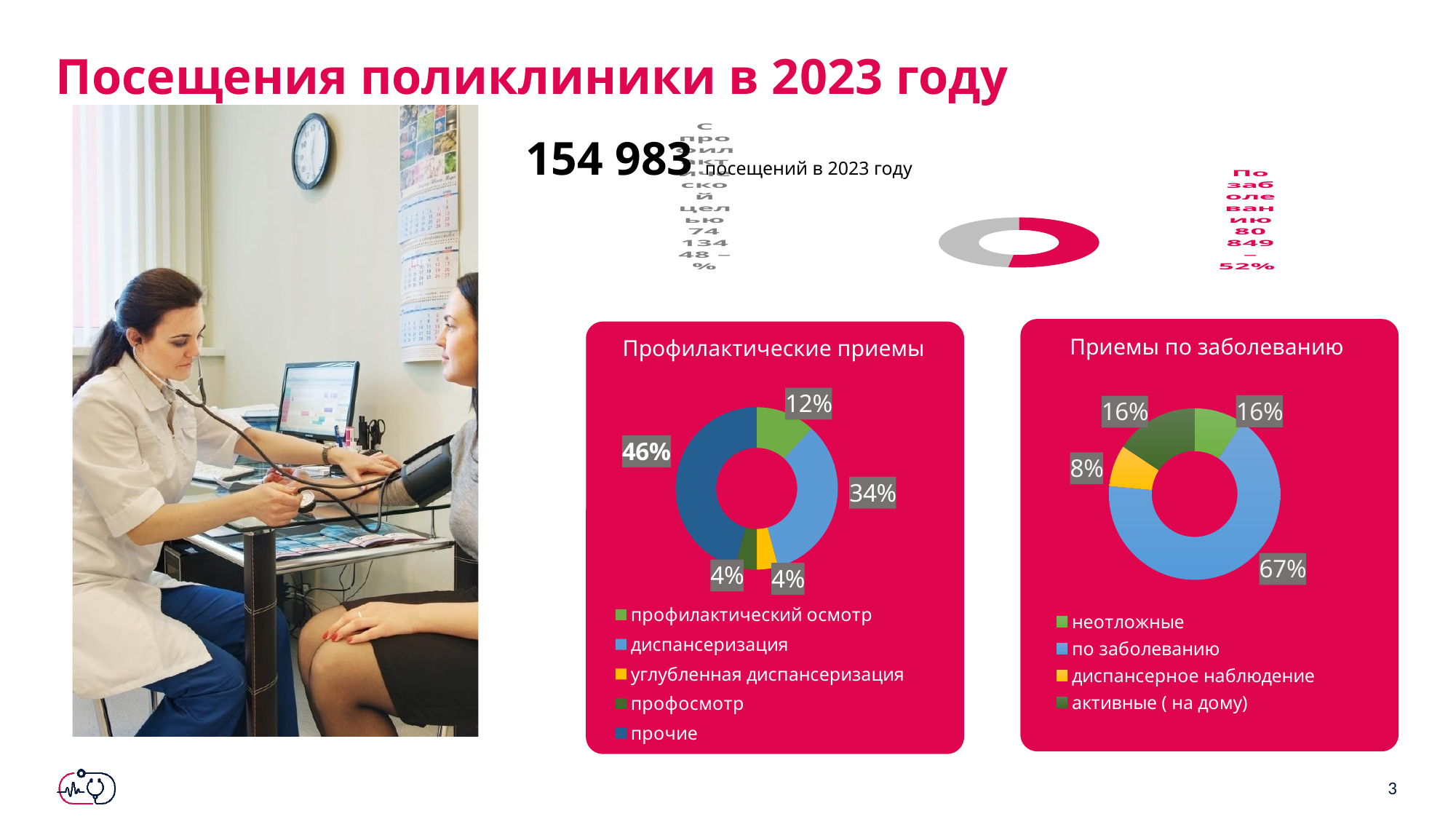
In the 'Профилактические приемы' chart, how many categories does the legend list? 5 In the 'Приемы по заболеванию' chart, what share is labelled for 'по заболеванию'? 67% What type of chart is used for 'Приемы по заболеванию'? Donut (pie) chart In the 'Приемы по заболеванию' chart, which category has the smallest share? диспансерное наблюдение In the 'Приемы по заболеванию' chart, what share is labelled for 'диспансерное наблюдение'? 8% In the 'Приемы по заболеванию' chart, which is larger: the share for 'неотложные' or the share for 'диспансерное наблюдение'? неотложные In the 'Профилактические приемы' chart, what share is labelled for 'прочие'? 46% In the 'Профилактические приемы' chart, what share is labelled for 'диспансеризация'? 34% In the 'Профилактические приемы' chart, what is the difference between the shares for 'прочие' and 'диспансеризация'? 12% In the 'Профилактические приемы' chart, which category has the largest share? прочие In the 'Профилактические приемы' chart, what share is labelled for 'профилактический осмотр'? 12% In the 'Приемы по заболеванию' chart, how many categories does the legend list? 4